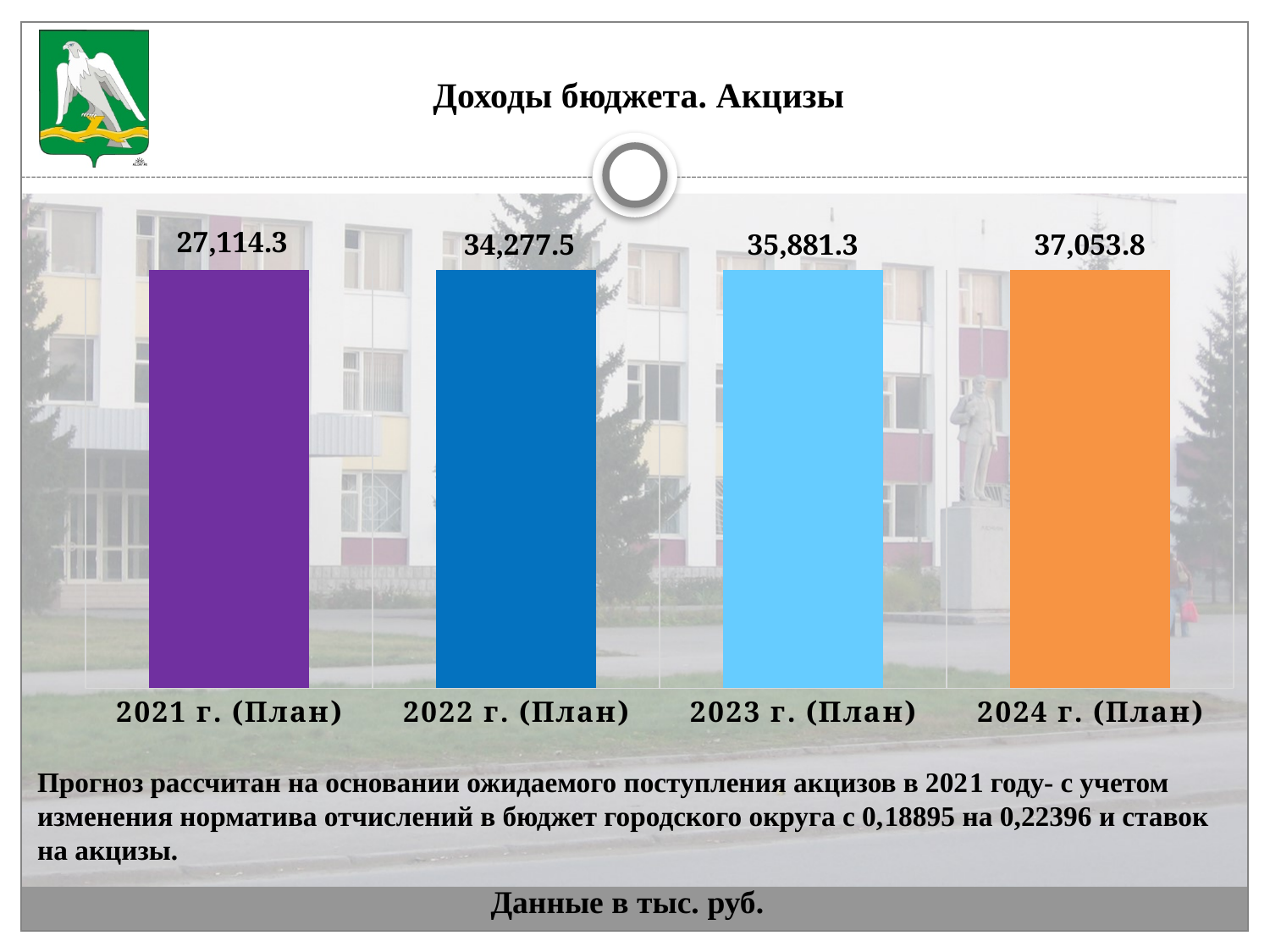
How many bars are shown in the chart? 4 What is the value for 2024 г. (План)? 37,053.8 Which is larger, the value for 2022 г. (План) or 2023 г. (План)? 2023 г. (План) Which year has the highest value? 2024 г. (План) What is the value for 2022 г. (План)? 34,277.5 What is the difference between the values for 2024 г. (План) and 2021 г. (План)? 9,939.5 What is the value for 2021 г. (План)? 27,114.3 Do the values rise or fall from 2021 to 2024? Rise Which year has the lowest value? 2021 г. (План) What is the value for 2023 г. (План)? 35,881.3 What is the difference between the values for 2023 г. (План) and 2022 г. (План)? 1,603.8 What kind of chart is shown on the slide? Bar chart